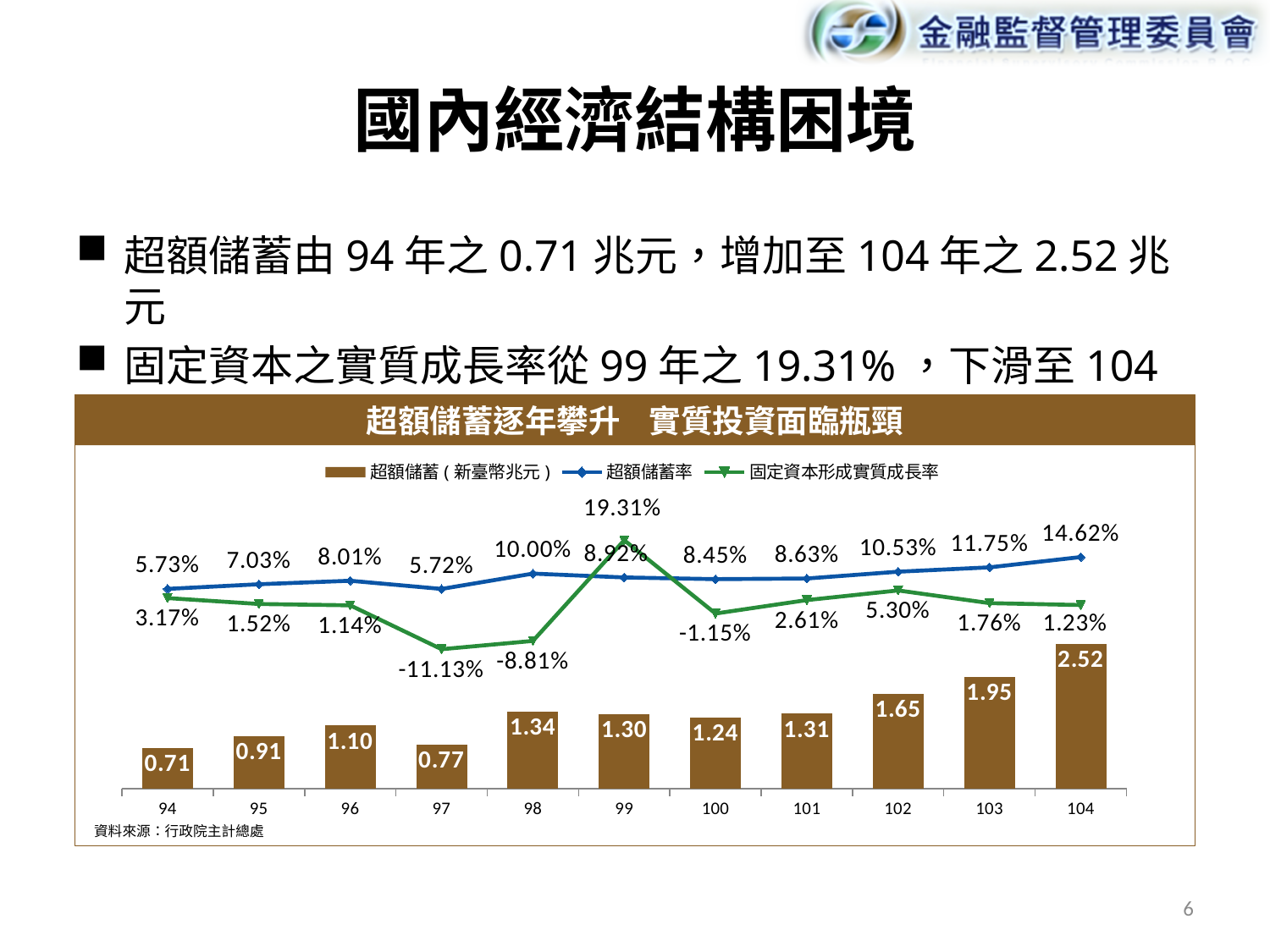
What is the value of 超額儲蓄 (新臺幣兆元) for year 104? 2.52 What is the difference in 超額儲蓄 (新臺幣兆元) between year 104 and year 94? 1.81 What is the 固定資本形成實質成長率 for year 97? -11.13% In which year is the 固定資本形成實質成長率 the highest? 99 Does the 超額儲蓄率 line rise or fall from year 101 to year 104? Rise In which year is 超額儲蓄 (新臺幣兆元) the lowest? 94 Which is larger, the 超額儲蓄 value for year 98 or for year 99? 98 What is the 超額儲蓄率 for year 98? 10.00% How many series does the chart legend list? 3 What is the title of the chart? 超額儲蓄逐年攀升 實質投資面臨瓶頸 How many years are shown on the x axis of the chart? 11 What kind of chart is used for the 超額儲蓄 (新臺幣兆元) series? Bar chart